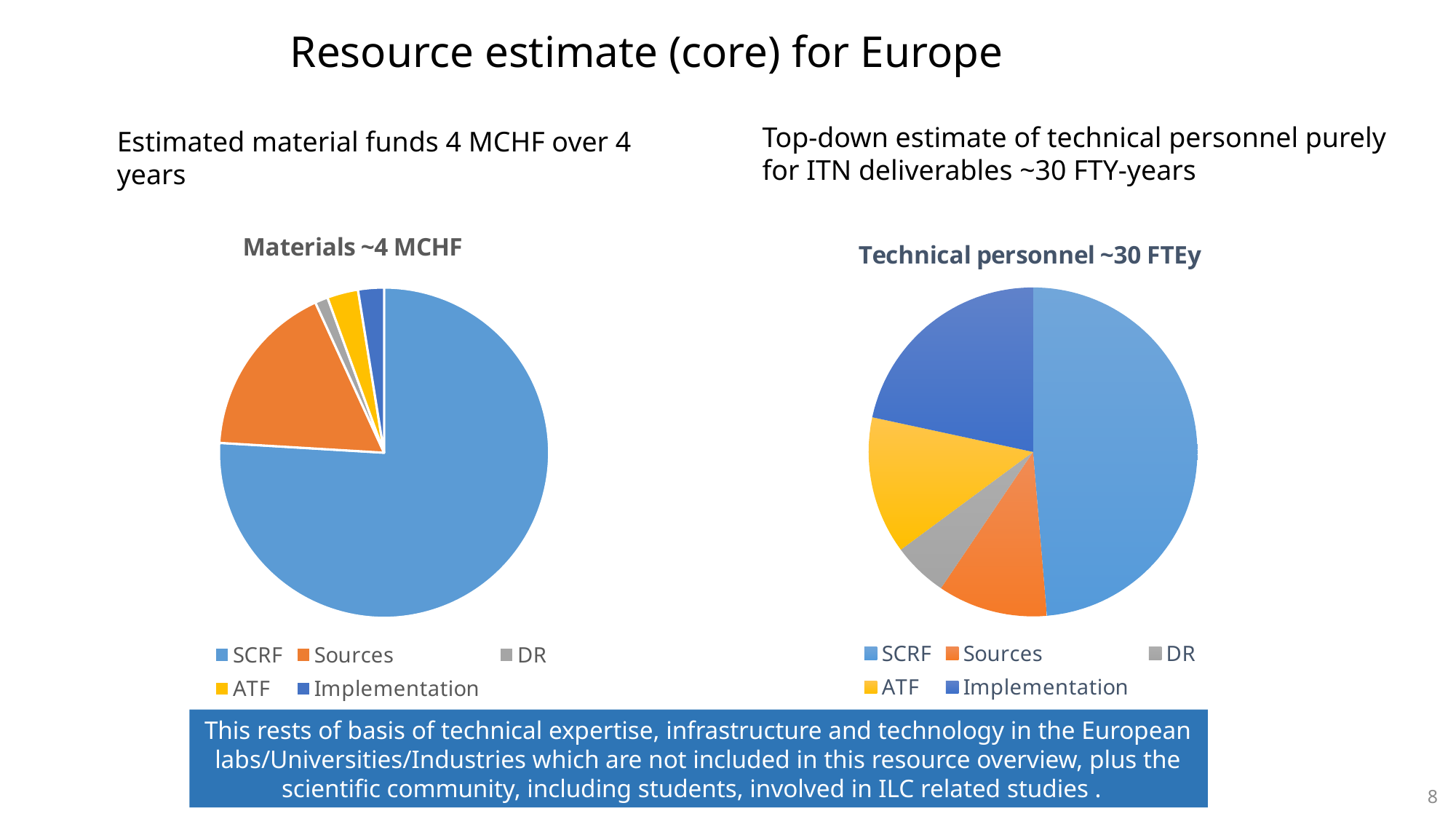
In the 'Technical personnel ~30 FTEy' chart, which slice is larger, Implementation or Sources? Implementation In the 'Technical personnel ~30 FTEy' chart, which colour represents Implementation? dark blue How many categories does the legend of the 'Technical personnel ~30 FTEy' chart list? 5 In the 'Technical personnel ~30 FTEy' chart, which slice is larger, ATF or DR? ATF In the 'Technical personnel ~30 FTEy' chart, which category has the largest slice? SCRF In the 'Technical personnel ~30 FTEy' chart, which category has the smallest slice? DR In the 'Materials ~4 MCHF' chart, which slice is larger, Sources or ATF? Sources What kind of chart is the 'Materials ~4 MCHF' chart? pie chart What is the title of the pie chart on the left of the slide? Materials ~4 MCHF What kind of chart is the 'Technical personnel ~30 FTEy' chart? pie chart In the 'Materials ~4 MCHF' chart, which category has the largest slice? SCRF How many categories does the legend of the 'Materials ~4 MCHF' chart list? 5